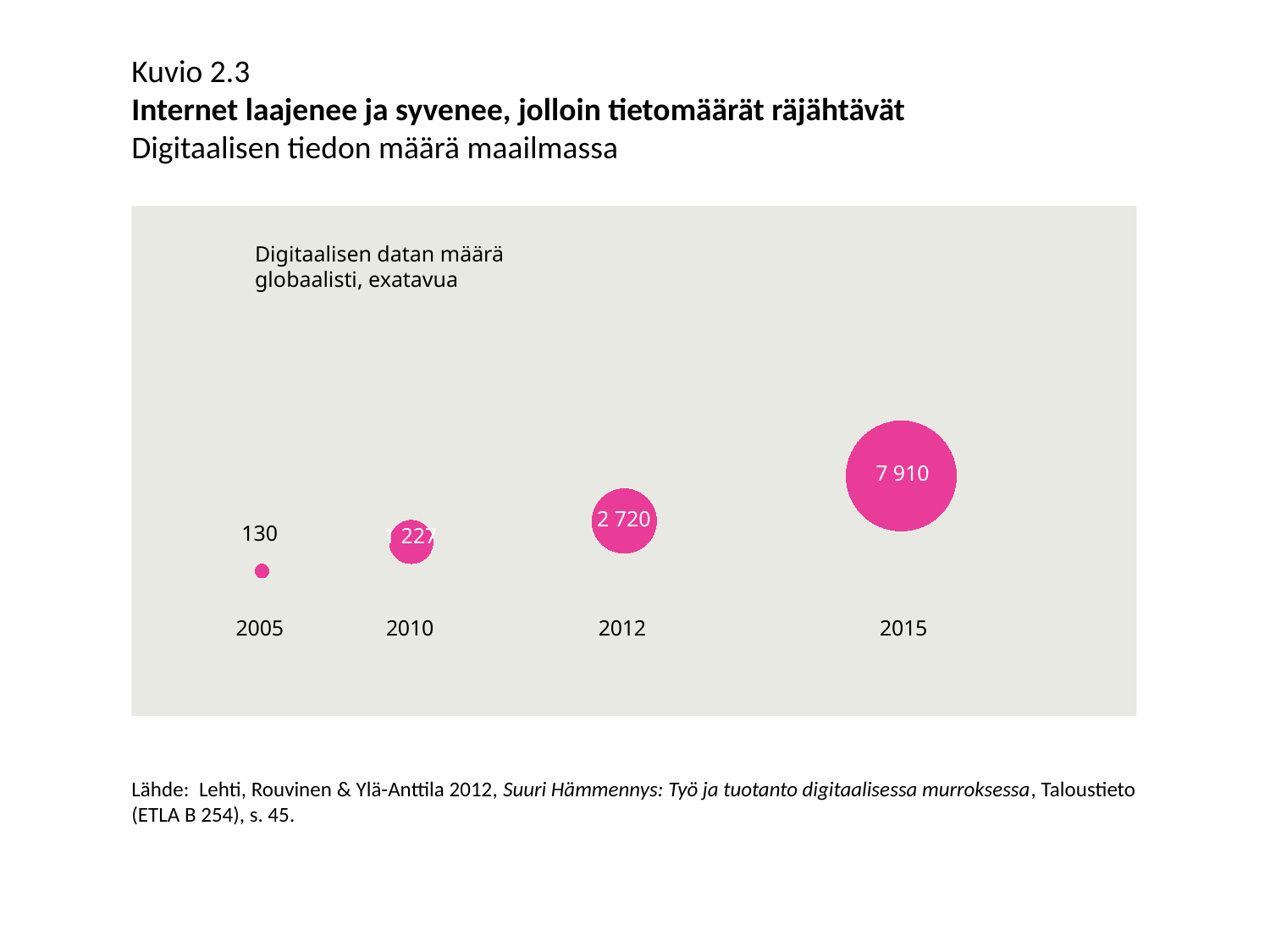
What is the difference between the values for 2015 and 2012? 5 190 What is the value for 2012? 2 720 What is the value for 2015? 7 910 Which is larger, the value for 2010 or the value for 2005? 2010 Do the values rise or fall from 2005 to 2015? Rise How many years are plotted in the chart? 4 What kind of chart is shown? Bubble chart What is the difference between the values for 2012 and 2005? 2 590 Which year has the lowest value? 2005 Which year has the highest value? 2015 What is the value for 2005? 130 What unit is the digital data amount measured in, according to the chart title? exatavua